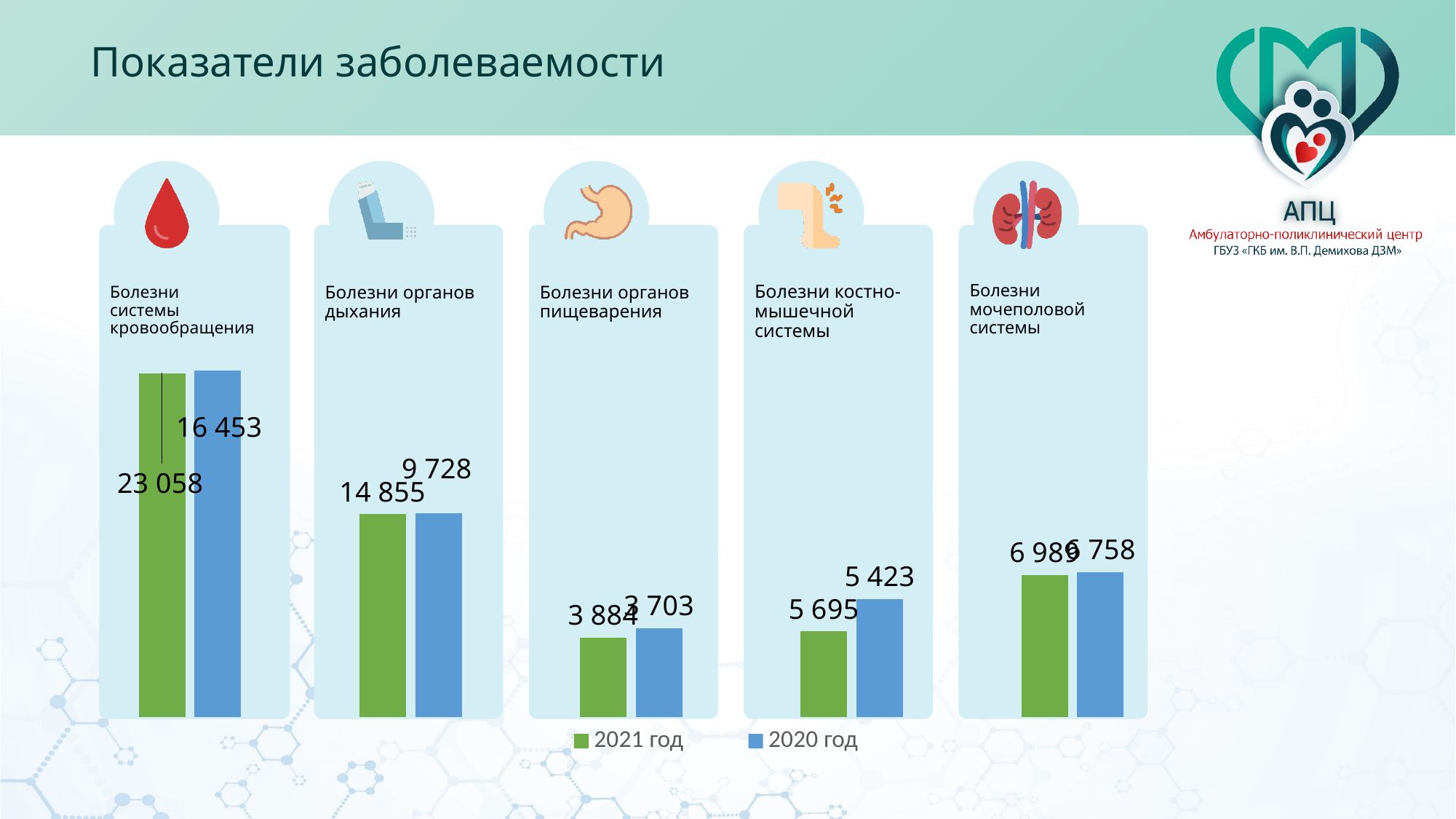
What is the difference between the 2021 год and 2020 год values for Болезни органов дыхания? 5 127 What is the value for 2020 год for Болезни костно-мышечной системы? 5 423 How many series does the legend list? 2 What is the difference between the 2021 год and 2020 год values for Болезни системы кровообращения? 6 605 Which disease category has the highest value for 2021 год? Болезни системы кровообращения What is the value for 2020 год for Болезни мочеполовой системы? 6 758 What is the value for 2020 год for Болезни органов дыхания? 9 728 What is the value for 2021 год for Болезни органов пищеварения? 3 884 What is the value for 2021 год for Болезни системы кровообращения? 23 058 How many disease categories are shown in the chart? 5 Which disease category has the lowest value for 2020 год? Болезни органов пищеварения